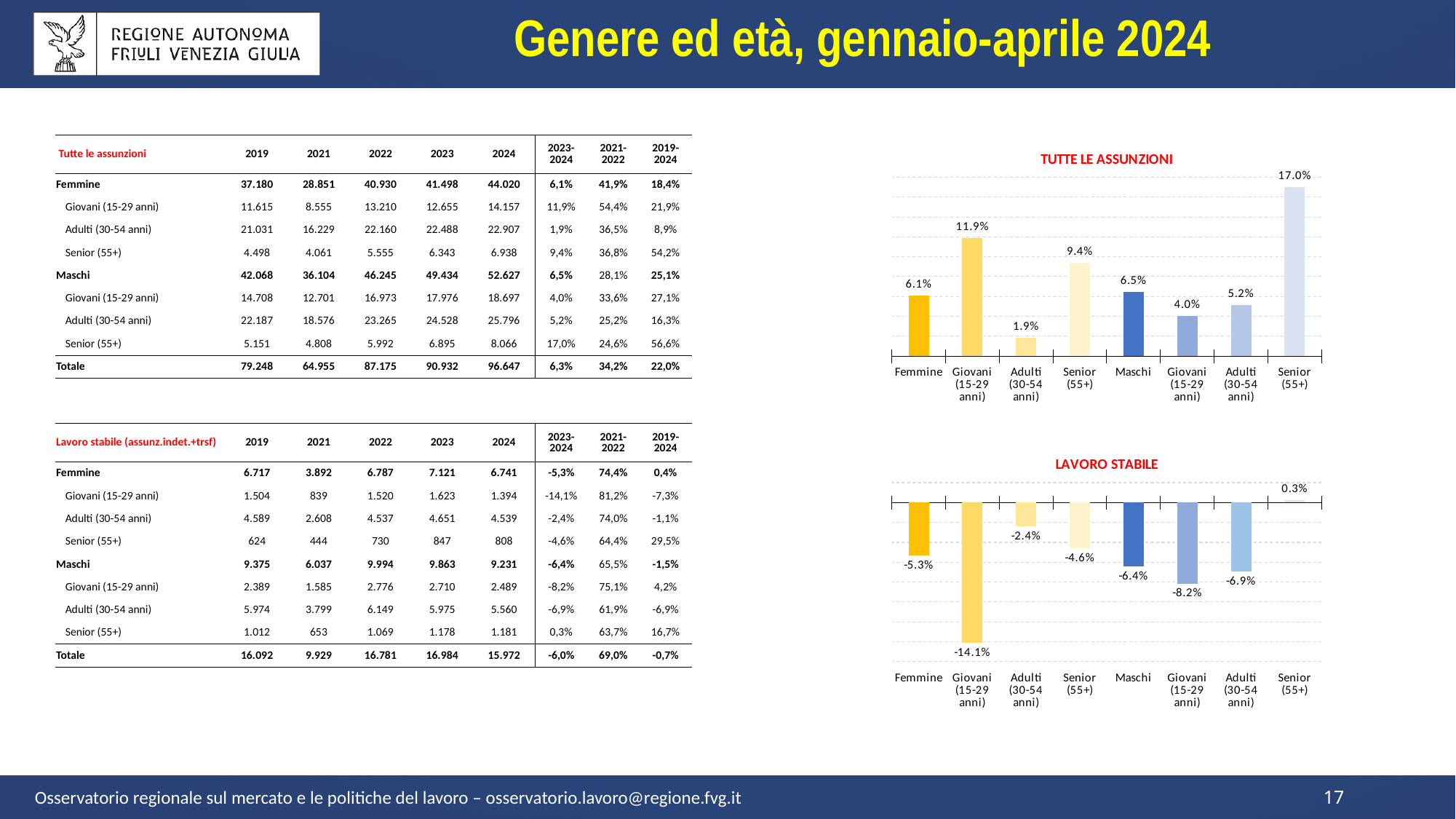
In the LAVORO STABILE chart, which is larger: the value for Femmine or the value for Maschi? Femmine In the TUTTE LE ASSUNZIONI chart, which category has the highest value? Senior (55+) (the last bar, in the Maschi group) In the TUTTE LE ASSUNZIONI chart, how many bars are plotted? 8 What type of chart is the LAVORO STABILE chart? Bar chart In the LAVORO STABILE chart, which is the only bar with a positive value? Senior (55+) (the last bar, 0.3%) In the TUTTE LE ASSUNZIONI chart, what is the value for Maschi? 6.5% In the TUTTE LE ASSUNZIONI chart, which category has the lowest value? Adulti (30-54 anni) (the bar after Giovani in the Femmine group, 1.9%) In the LAVORO STABILE chart, what is the value for Femmine? -5.3% In the LAVORO STABILE chart, what is the value for Maschi? -6.4% In the LAVORO STABILE chart, which category has the lowest value? Giovani (15-29 anni) (the bar right after Femmine, -14.1%) In the TUTTE LE ASSUNZIONI chart, what is the value for Femmine? 6.1% In the TUTTE LE ASSUNZIONI chart, what is the difference between the last bar, Senior (55+), and the Femmine bar? 10.9 percentage points